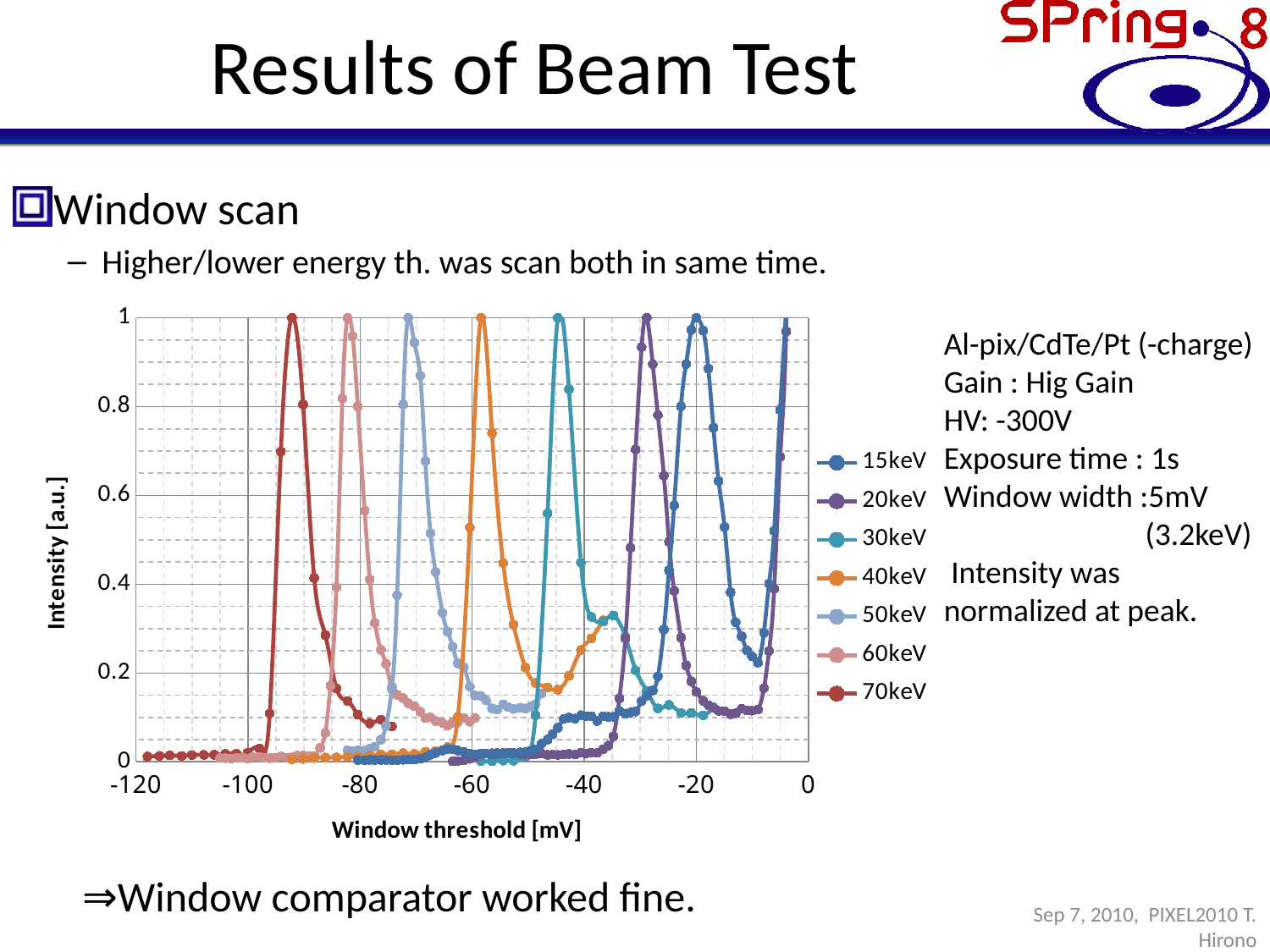
At a window threshold of -20 mV, which series has the higher intensity, 15keV or 20keV? 15keV What is the peak intensity value of the 40keV series? 1 Is the 30keV value at a window threshold of -40 mV greater or less than 0.2? greater Which series reaches its peak at the most negative window threshold? 70keV At a window threshold of -80 mV, which series has the higher intensity, 60keV or 15keV? 60keV Is the 15keV value at a window threshold of -60 mV greater or less than 0.2? less What is the title of the x axis of the chart? Window threshold [mV] What kind of chart is shown on the slide? line chart Is the 70keV value at a window threshold of -100 mV greater or less than 0.2? less How many series does the legend list? 7